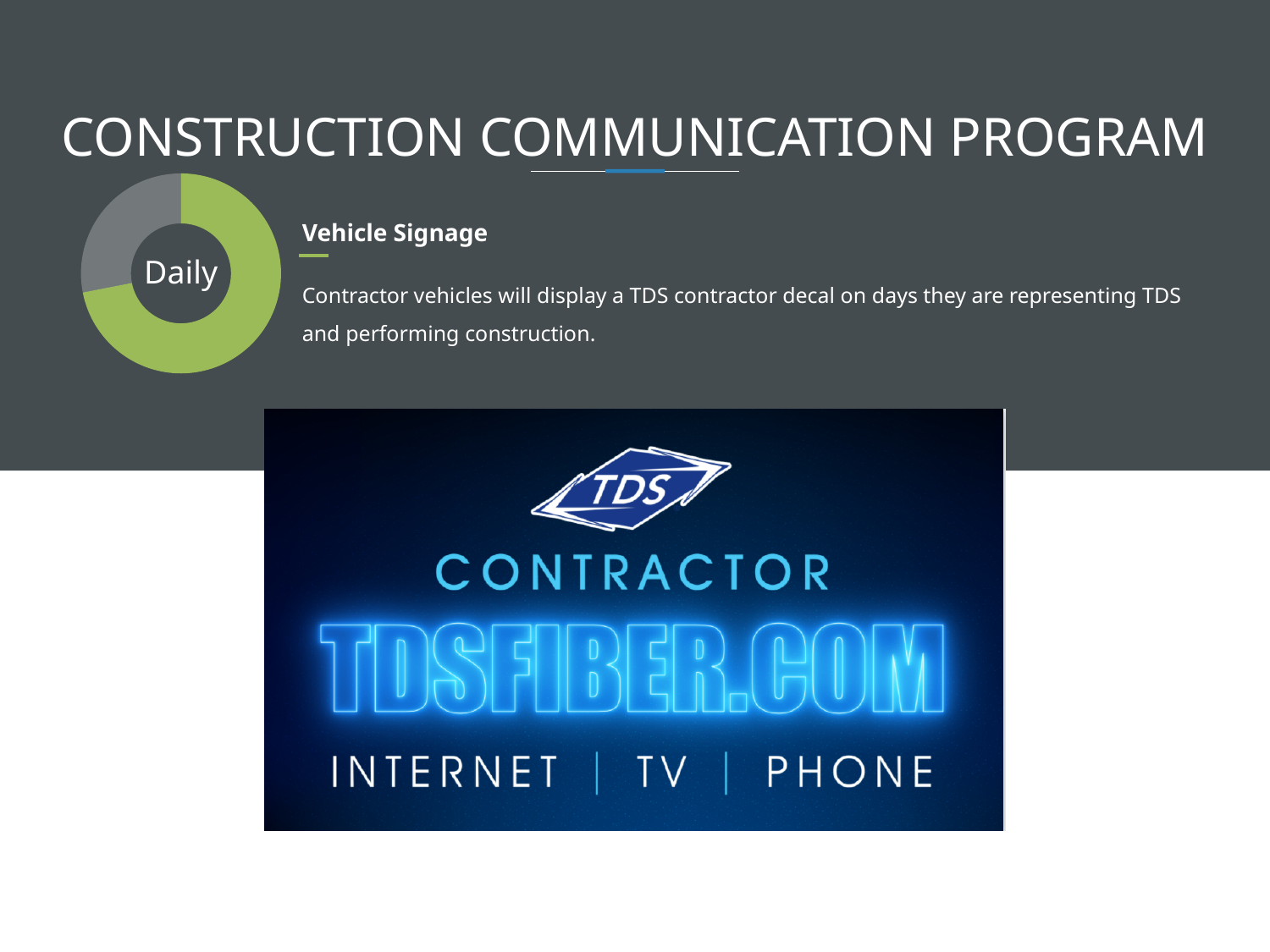
What word is printed in the centre of the donut chart? Daily Does the green slice of the donut chart cover more or less than half of the ring? More Which slice of the donut chart is larger, the green one or the gray one? The green one How many slices does the donut chart have? 2 What kind of chart is shown on the left of the slide? Donut chart Which colour slice takes up the smallest share of the donut chart? Gray